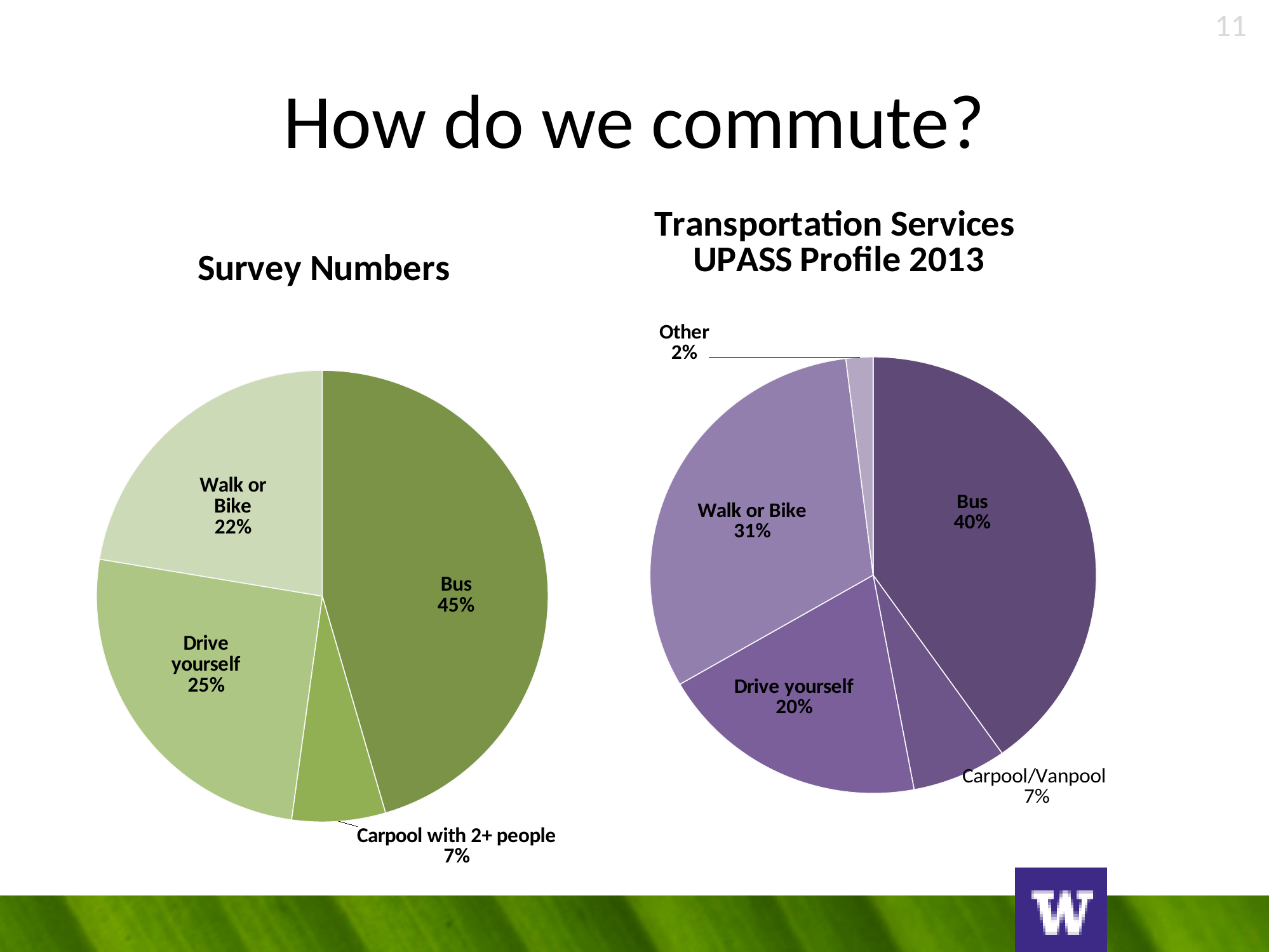
In the Survey Numbers chart, what percentage is shown for Drive yourself? 25% How many categories are shown in the Survey Numbers chart? 4 In the Transportation Services UPASS Profile 2013 chart, what percentage is shown for Other? 2% In the Transportation Services UPASS Profile 2013 chart, which category has the smallest share? Other In the Transportation Services UPASS Profile 2013 chart, which category has the largest share? Bus In the Survey Numbers chart, what percentage is shown for Carpool with 2+ people? 7% What type of chart is the Survey Numbers chart? Pie chart In the Survey Numbers chart, which category has the smallest share? Carpool with 2+ people In the Survey Numbers chart, how many percentage points higher is Bus than Walk or Bike? 23 In the Survey Numbers chart, which is larger: Drive yourself or Walk or Bike? Drive yourself In the Survey Numbers chart, what share of commuters take the Bus? 45% In the Transportation Services UPASS Profile 2013 chart, what share is Walk or Bike? 31%